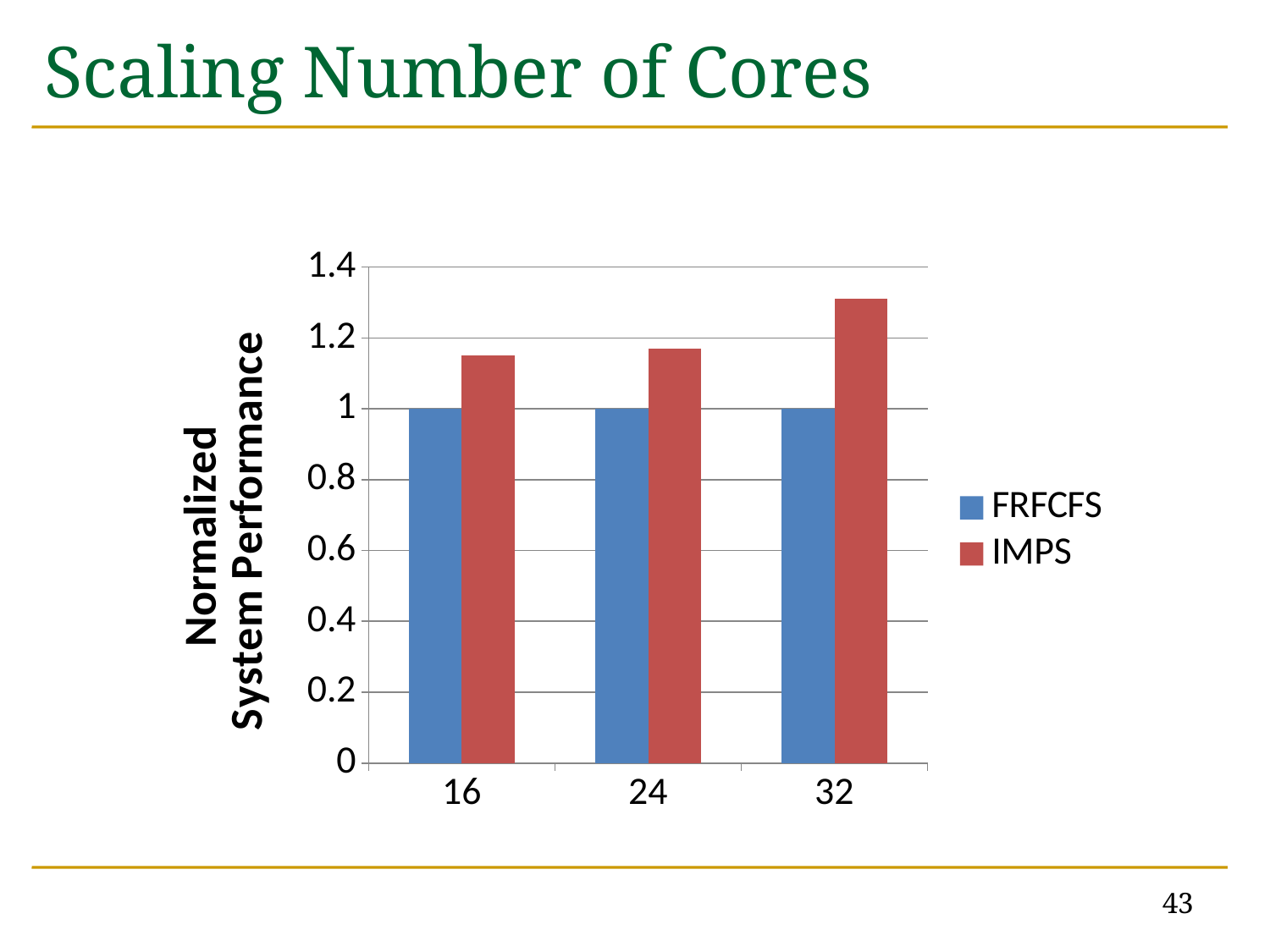
Is the IMPS value at 32 cores greater or less than 1.2? greater At which number of cores is the IMPS value highest? 32 What kind of chart is shown on the slide? bar chart How many core-count categories are shown on the x axis? 3 How many series does the legend list? 2 Do the IMPS values rise or fall as the number of cores increases from 16 to 32? rise Is the IMPS value at 16 cores greater or less than 1? greater What is the label of the y axis? Normalized System Performance What is the normalized system performance of FRFCFS at 32 cores? 1 Is the IMPS value at 16 cores greater or less than 1.2? less At 24 cores, which series has the larger value, FRFCFS or IMPS? IMPS What is the normalized system performance of FRFCFS at 16 cores? 1